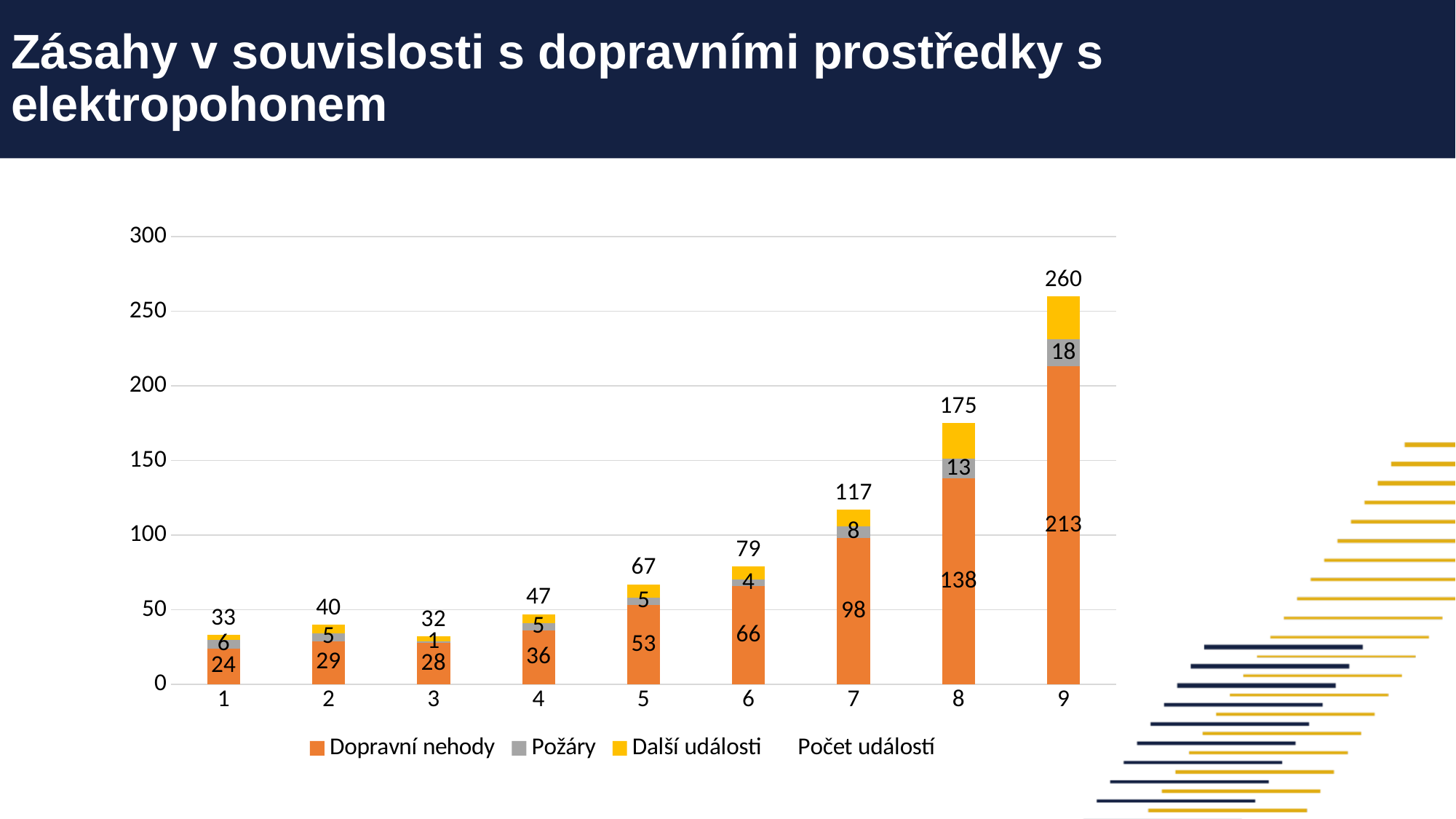
How many categories are shown on the x axis? 9 What is the value of Požáry for category 8? 13 Which category has the lowest total number of events? 3 What is the value of Dopravní nehody for category 9? 213 What is the total of the stacked bar for category 7? 117 Which category has the highest total number of events? 9 How many entries does the legend list? 4 Do the total values rise or fall from category 4 to category 9? rise Which category has the larger Požáry value, category 1 or category 2? 1 What is the title of the slide? Zásahy v souvislosti s dopravními prostředky s elektropohonem What is the difference between the Dopravní nehody values for category 9 and category 8? 75 What kind of chart is shown on the slide? stacked bar chart